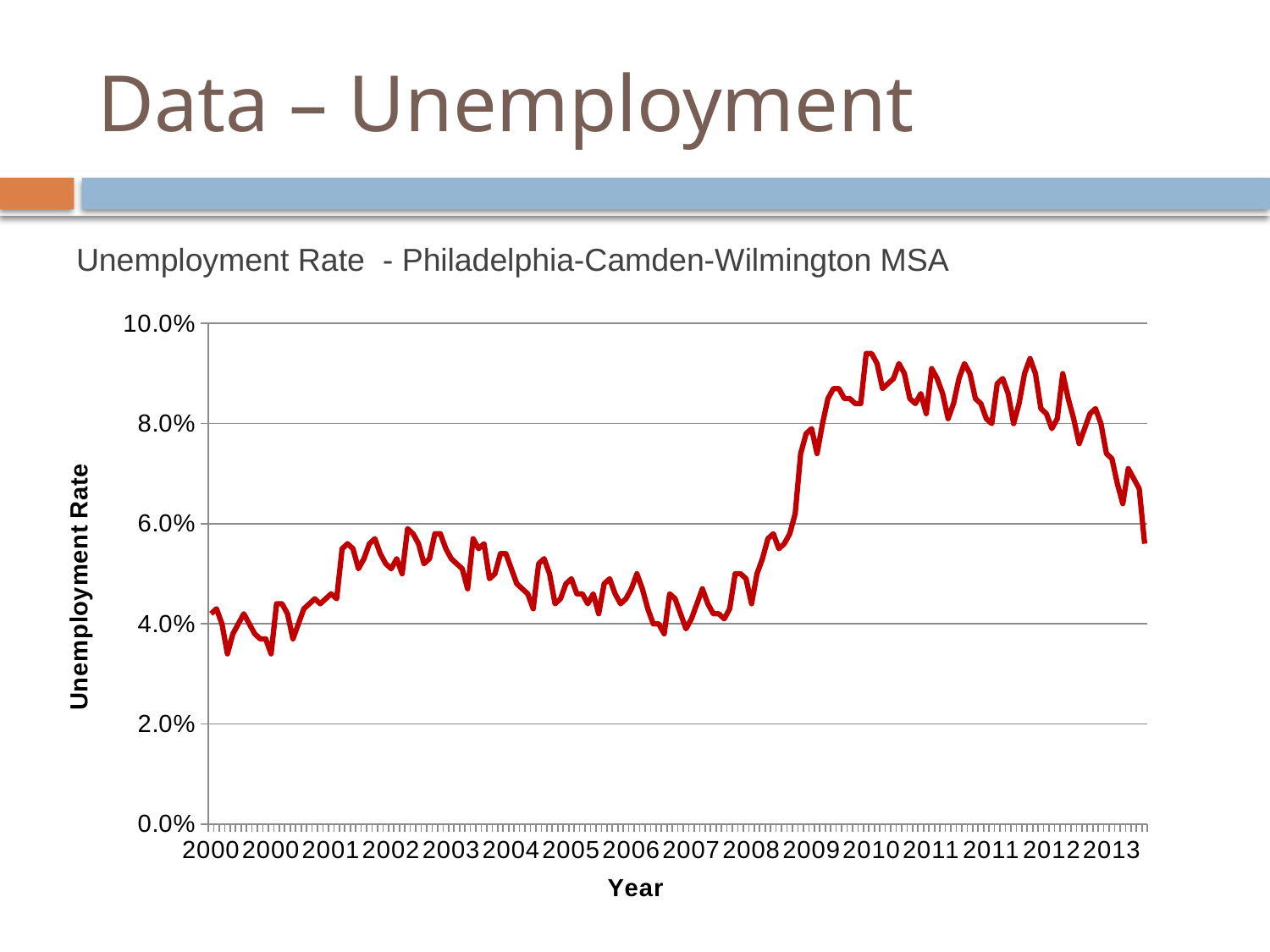
Does the unemployment rate rise or fall between 2008 and 2009? rise Is the unemployment rate in 2005 greater or less than 6.0%? less What kind of chart is shown on the slide? Line chart Is the unemployment rate in 2011 greater or less than 6.0%? greater What is the label of the vertical axis? Unemployment Rate What is the title of the chart? Unemployment Rate - Philadelphia-Camden-Wilmington MSA How many lines are plotted on the chart? 1 Is the unemployment rate in 2010 greater or less than 8.0%? greater Does the unemployment rate rise or fall from 2012 to the end of 2013? fall Which year has a lower unemployment rate, 2003 or 2011? 2003 Which year has a higher unemployment rate, 2005 or 2010? 2010